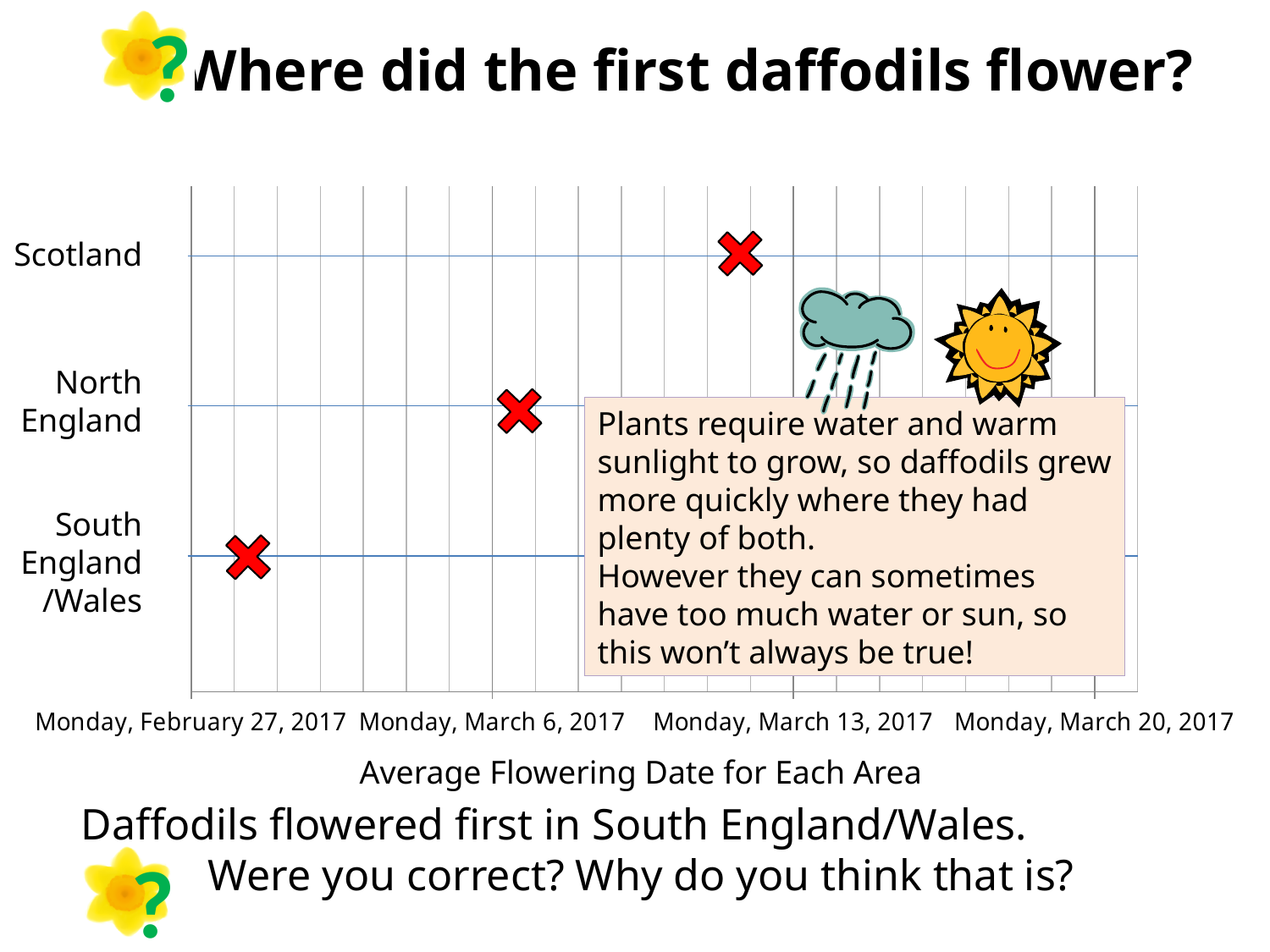
Is the average flowering date for North England before or after Monday, March 6, 2017? after What kind of chart is shown on the slide? scatter chart Which flowered later, South England/Wales or North England? North England Which flowered earlier, North England or Scotland? North England Is the average flowering date for South England/Wales before or after Monday, March 6, 2017? before Moving from South England/Wales up to Scotland, do the average flowering dates get earlier or later? later Which area has the latest average flowering date on the chart? Scotland Is the average flowering date for Scotland before or after Monday, March 6, 2017? after What is the title shown beneath the chart? Average Flowering Date for Each Area How many areas are plotted on the chart? 3 Which area has the earliest average flowering date on the chart? South England/Wales